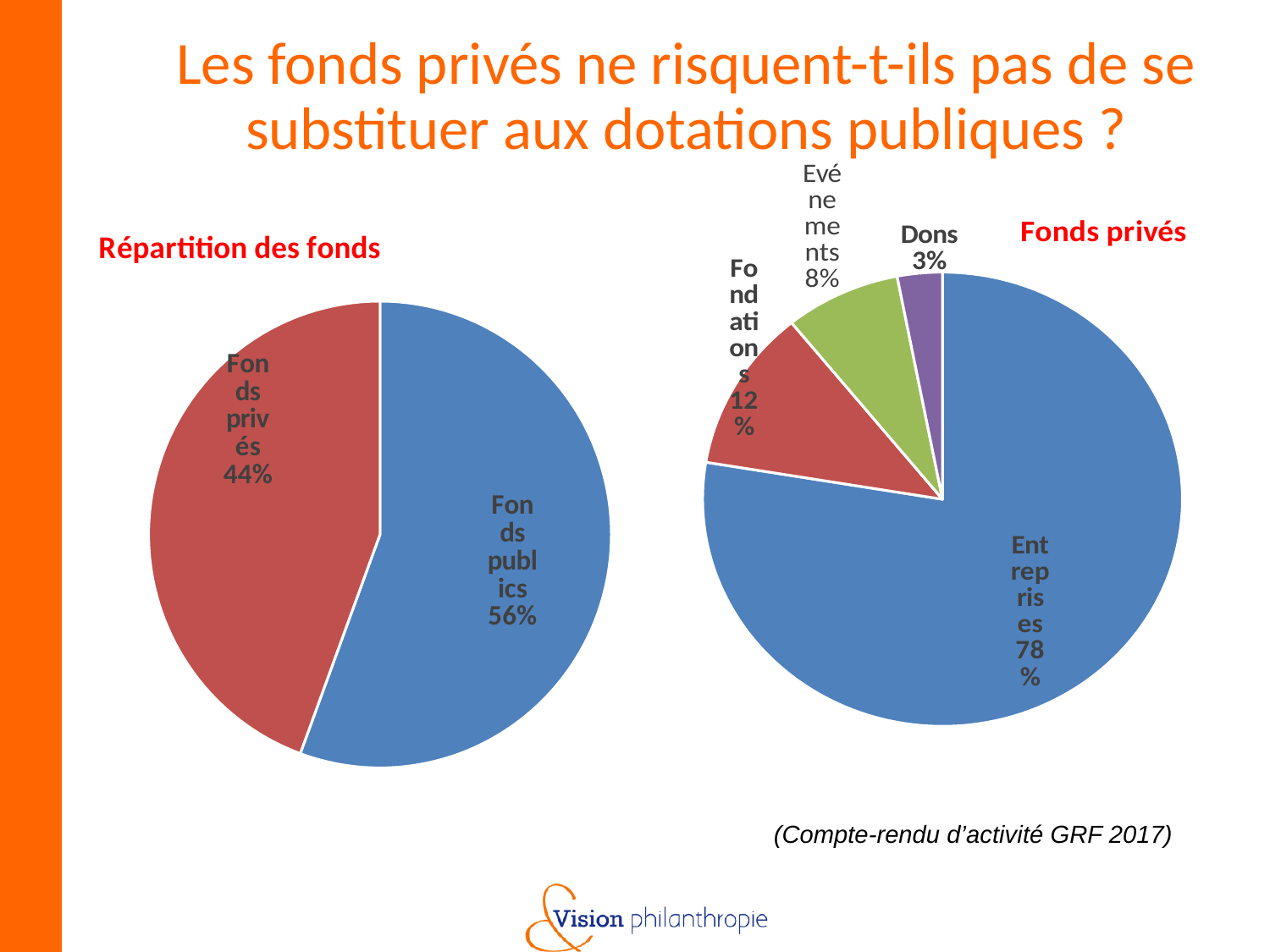
In the 'Répartition des fonds' chart, what share is labelled for Fonds privés? 44% In the 'Fonds privés' chart, what share is labelled for Entreprises? 78% In the 'Répartition des fonds' chart, which slice is larger, Fonds publics or Fonds privés? Fonds publics What kind of chart is the 'Répartition des fonds' chart? Pie chart In the 'Fonds privés' chart, what is the difference in percentage points between Fondations and Evénements? 4 In the 'Fonds privés' chart, which category has the smallest slice? Dons In the 'Fonds privés' chart, which category has the largest slice? Entreprises In the 'Répartition des fonds' chart, what share is labelled for Fonds publics? 56% How many slices does the 'Fonds privés' pie chart have? 4 In the 'Fonds privés' chart, what share is labelled for Dons? 3% In the 'Fonds privés' chart, what share is labelled for Fondations? 12% In the 'Répartition des fonds' chart, what is the difference in percentage points between Fonds publics and Fonds privés? 12